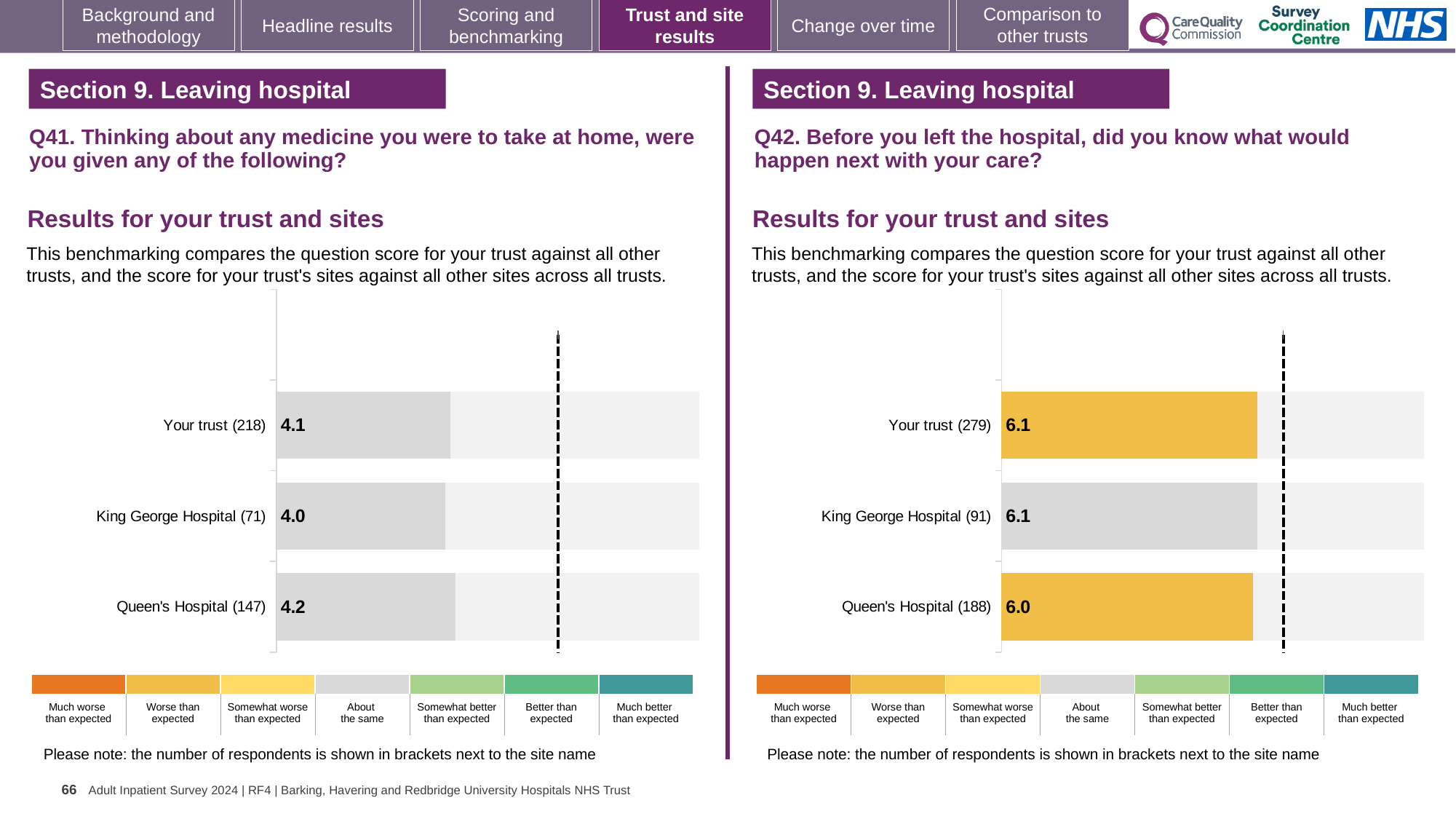
In the Q42 chart on the right, how many bars are plotted? 3 In the Q41 chart on the left, what is the score for King George Hospital (71)? 4.0 In the Q41 chart on the left, what is the difference between the scores for Queen's Hospital (147) and King George Hospital (71)? 0.2 In the Q42 chart on the right, which site or trust has the lowest score? Queen's Hospital (188) In the Q42 chart on the right, what is the score for Your trust (279)? 6.1 In the Q42 chart on the right, which benchmark category does the colour of the Your trust (279) bar correspond to? Worse than expected In the Q41 chart on the left, which benchmark category does the colour of the Queen's Hospital (147) bar correspond to? About the same What kind of chart is used in the Q41 chart on the left? Bar chart In the Q41 chart on the left, which site or trust has the highest score? Queen's Hospital (147) In the Q42 chart on the right, what is the score for Queen's Hospital (188)? 6.0 In the Q41 chart on the left, which site or trust has the lowest score? King George Hospital (71) In the Q41 chart on the left, what is the score for Your trust (218)? 4.1